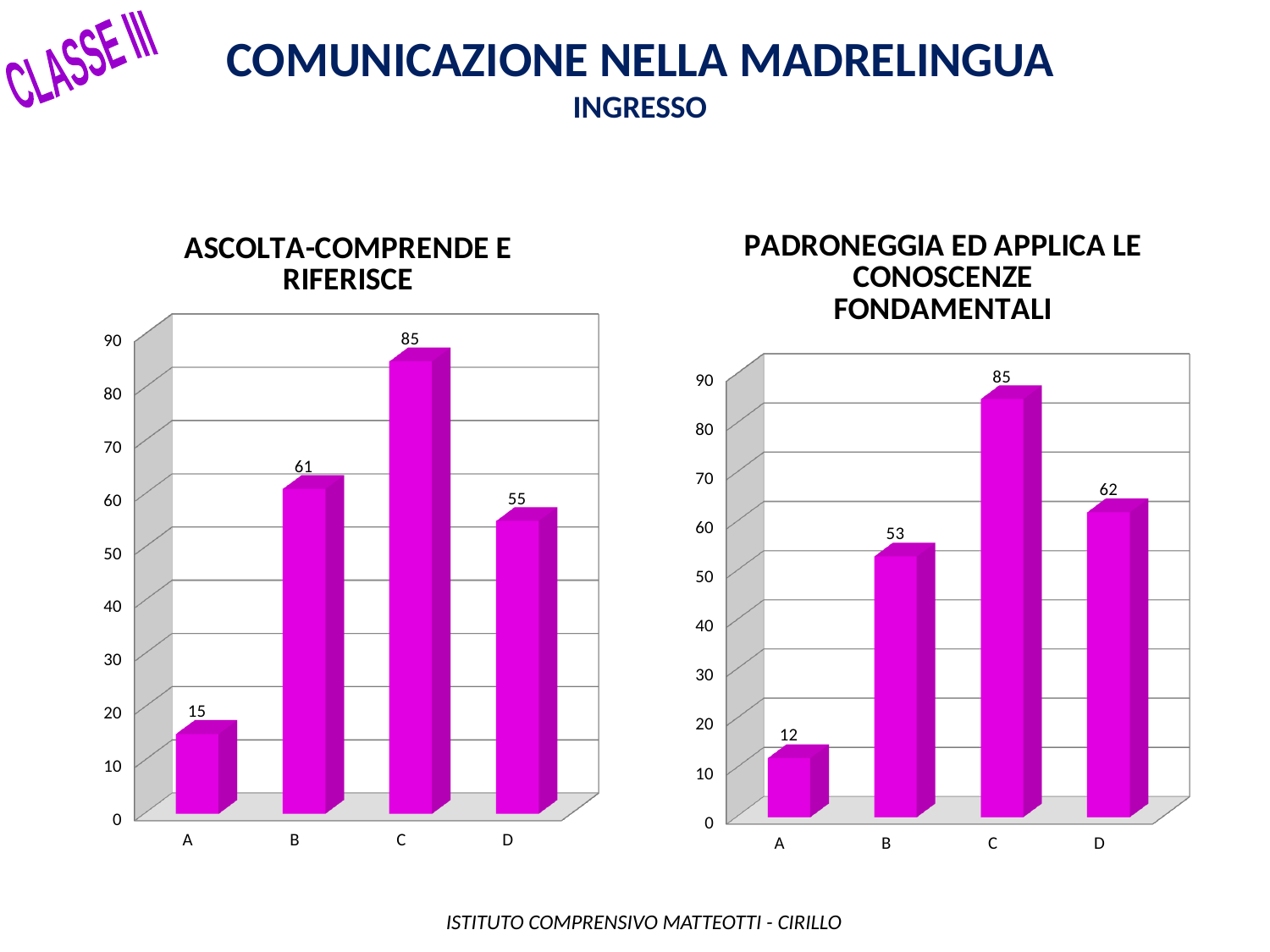
In the 'ASCOLTA-COMPRENDE E RIFERISCE' chart, what is the value for category C? 85 In the 'PADRONEGGIA ED APPLICA LE CONOSCENZE FONDAMENTALI' chart, what is the difference between the values for C and A? 73 How many categories are shown in the 'ASCOLTA-COMPRENDE E RIFERISCE' chart? 4 In the 'PADRONEGGIA ED APPLICA LE CONOSCENZE FONDAMENTALI' chart, which category has the lowest value? A In the 'PADRONEGGIA ED APPLICA LE CONOSCENZE FONDAMENTALI' chart, which is larger, the value for B or the value for D? D In the 'ASCOLTA-COMPRENDE E RIFERISCE' chart, what is the value for category A? 15 What colour are the bars in the 'ASCOLTA-COMPRENDE E RIFERISCE' chart? Magenta In the 'PADRONEGGIA ED APPLICA LE CONOSCENZE FONDAMENTALI' chart, what is the value for category B? 53 What type of chart is the 'PADRONEGGIA ED APPLICA LE CONOSCENZE FONDAMENTALI' chart? Bar chart In the 'ASCOLTA-COMPRENDE E RIFERISCE' chart, which category has the highest value? C In the 'PADRONEGGIA ED APPLICA LE CONOSCENZE FONDAMENTALI' chart, what is the value for category D? 62 In the 'ASCOLTA-COMPRENDE E RIFERISCE' chart, what is the difference between the values for B and D? 6